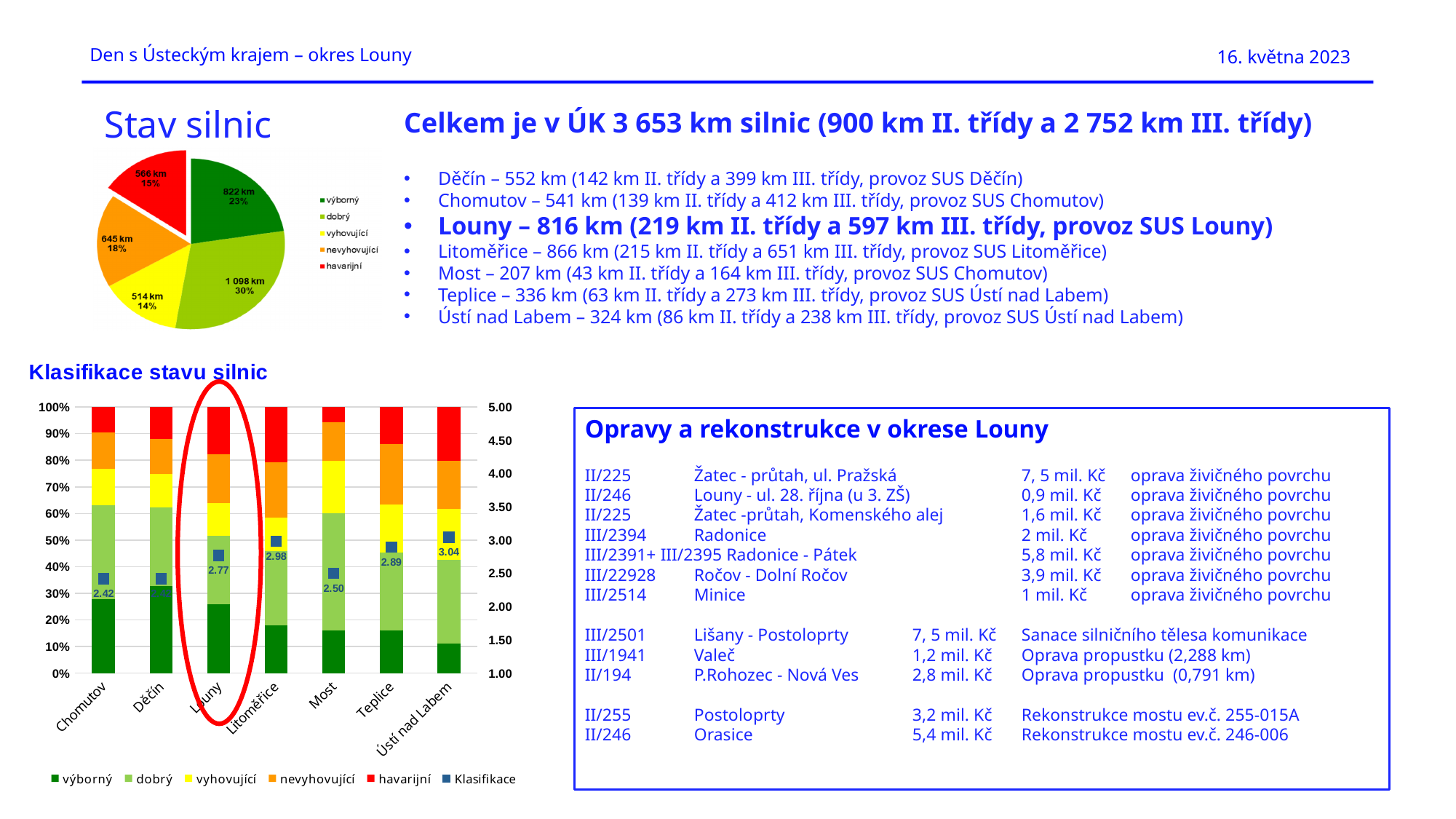
In the chart 'Klasifikace stavu silnic', which has the higher Klasifikace value, Louny or Litoměřice? Litoměřice In the chart 'Klasifikace stavu silnic', what is the difference between the Klasifikace values of Ústí nad Labem and Louny? 0.27 How many entries does the legend of the pie chart 'Stav silnic' list? 5 How many districts are shown on the x axis of the chart 'Klasifikace stavu silnic'? 7 In the chart 'Klasifikace stavu silnic', what is the Klasifikace value for Louny? 2.77 In the pie chart 'Stav silnic', what share of the roads is in the 'havarijní' category? 15% In the pie chart 'Stav silnic', how many km more are in 'dobrý' than in 'výborný'? 276 km In the chart 'Klasifikace stavu silnic', which district has the highest Klasifikace value? Ústí nad Labem In the pie chart 'Stav silnic', which category has the smallest slice? vyhovující In the chart 'Klasifikace stavu silnic', is the 'výborný' share for Ústí nad Labem greater or less than 20%? less In the pie chart 'Stav silnic', which category has the largest slice? dobrý In the pie chart 'Stav silnic', how many km are in the 'dobrý' category? 1 098 km